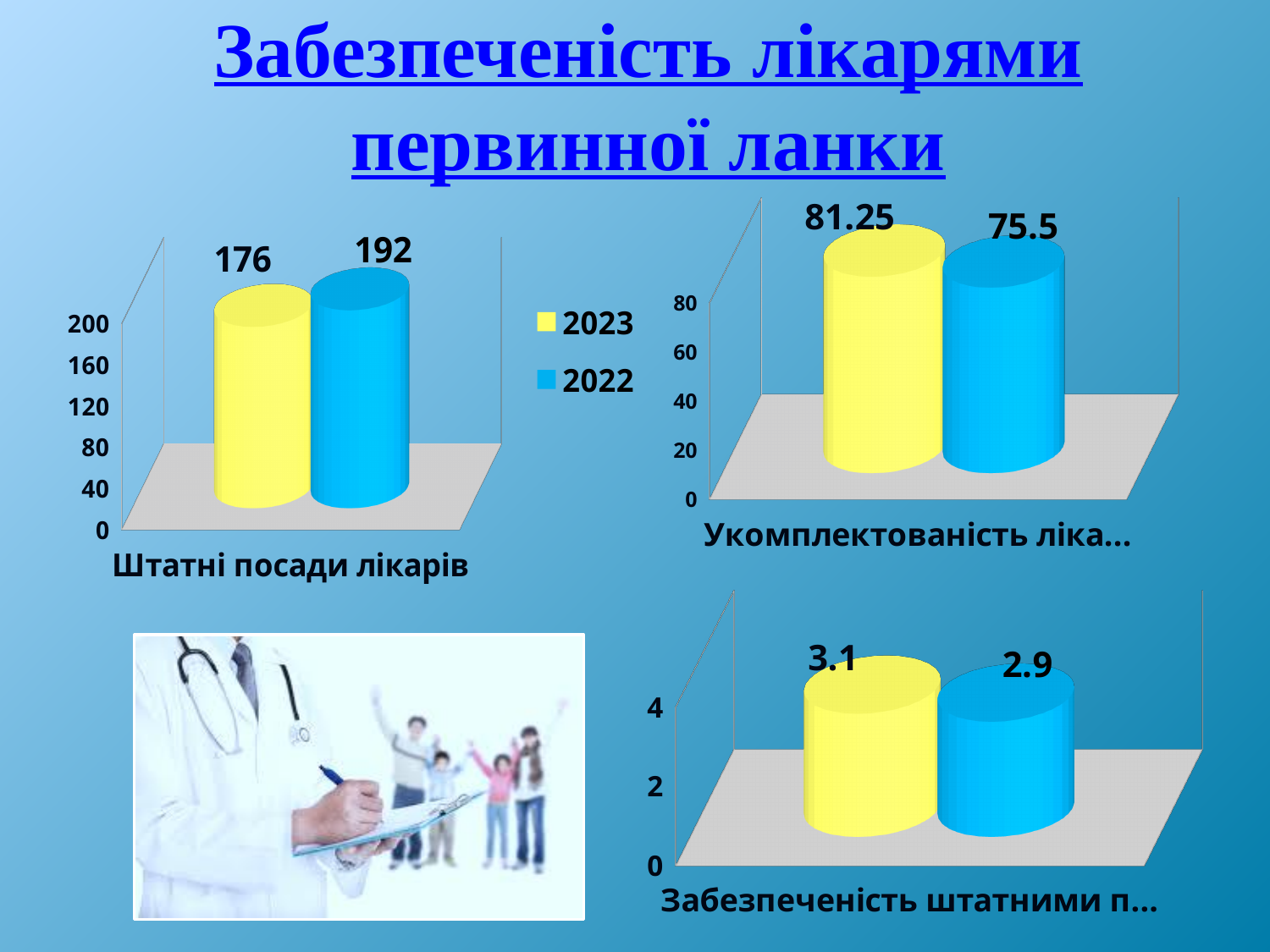
In the bottom-right chart ("Забезпеченість штатними п..."), what is the value for 2022? 2.9 In the top-right chart ("Укомплектованість ліка..."), what is the value for 2023? 81.25 In the top-right chart ("Укомплектованість ліка..."), what is the value for 2022? 75.5 In the chart titled "Штатні посади лікарів", what is the difference between the 2022 and 2023 values? 16 In the chart titled "Штатні посади лікарів", what is the value for 2023? 176 In the chart titled "Штатні посади лікарів", what is the value for 2022? 192 How many series does the legend on the slide list? 2 In the bottom-right chart ("Забезпеченість штатними п..."), what is the value for 2023? 3.1 What type of chart is the chart titled "Штатні посади лікарів"? Bar chart In the chart titled "Штатні посади лікарів", which year has the higher value? 2022 In the bottom-right chart ("Забезпеченість штатними п..."), what is the difference between the 2023 and 2022 values? 0.2 In the top-right chart ("Укомплектованість ліка..."), which year has the lower value? 2022